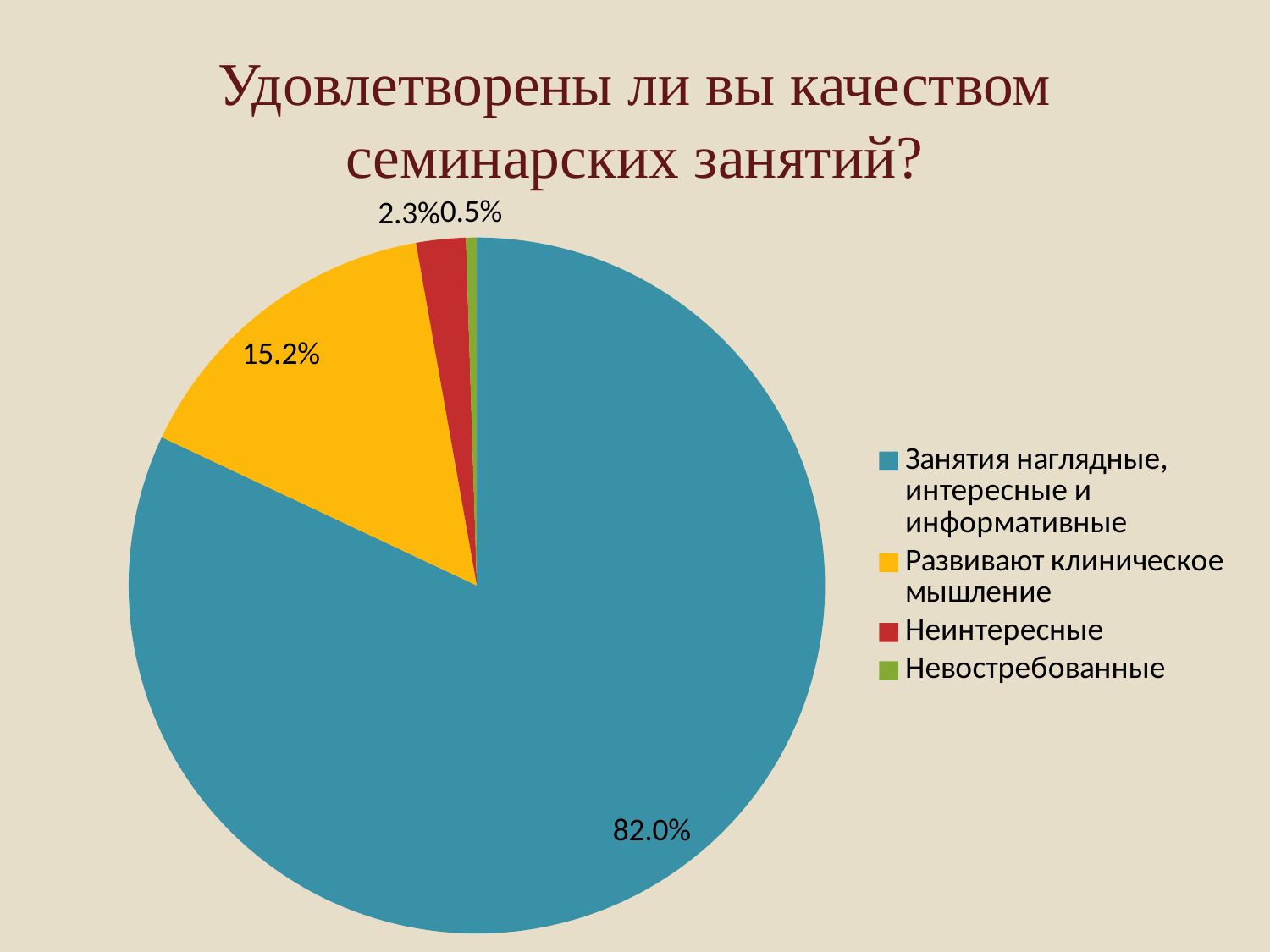
Which is larger: the share for "Неинтересные" or the share for "Невостребованные"? Неинтересные What is the difference between the shares for "Занятия наглядные, интересные и информативные" and "Развивают клиническое мышление"? 66.8% What share of the pie is labelled "Неинтересные"? 2.3% What colour is the slice for "Развивают клиническое мышление"? yellow What share of the pie is labelled "Невостребованные"? 0.5% What is the title of the chart on the slide? Удовлетворены ли вы качеством семинарских занятий? Which category has the smallest slice of the pie? Невостребованные Which category has the largest slice of the pie? Занятия наглядные, интересные и информативные What kind of chart is shown on the slide? pie chart How many categories does the legend list? 4 What share of the pie is labelled "Развивают клиническое мышление"? 15.2% What share of the pie is labelled "Занятия наглядные, интересные и информативные"? 82.0%